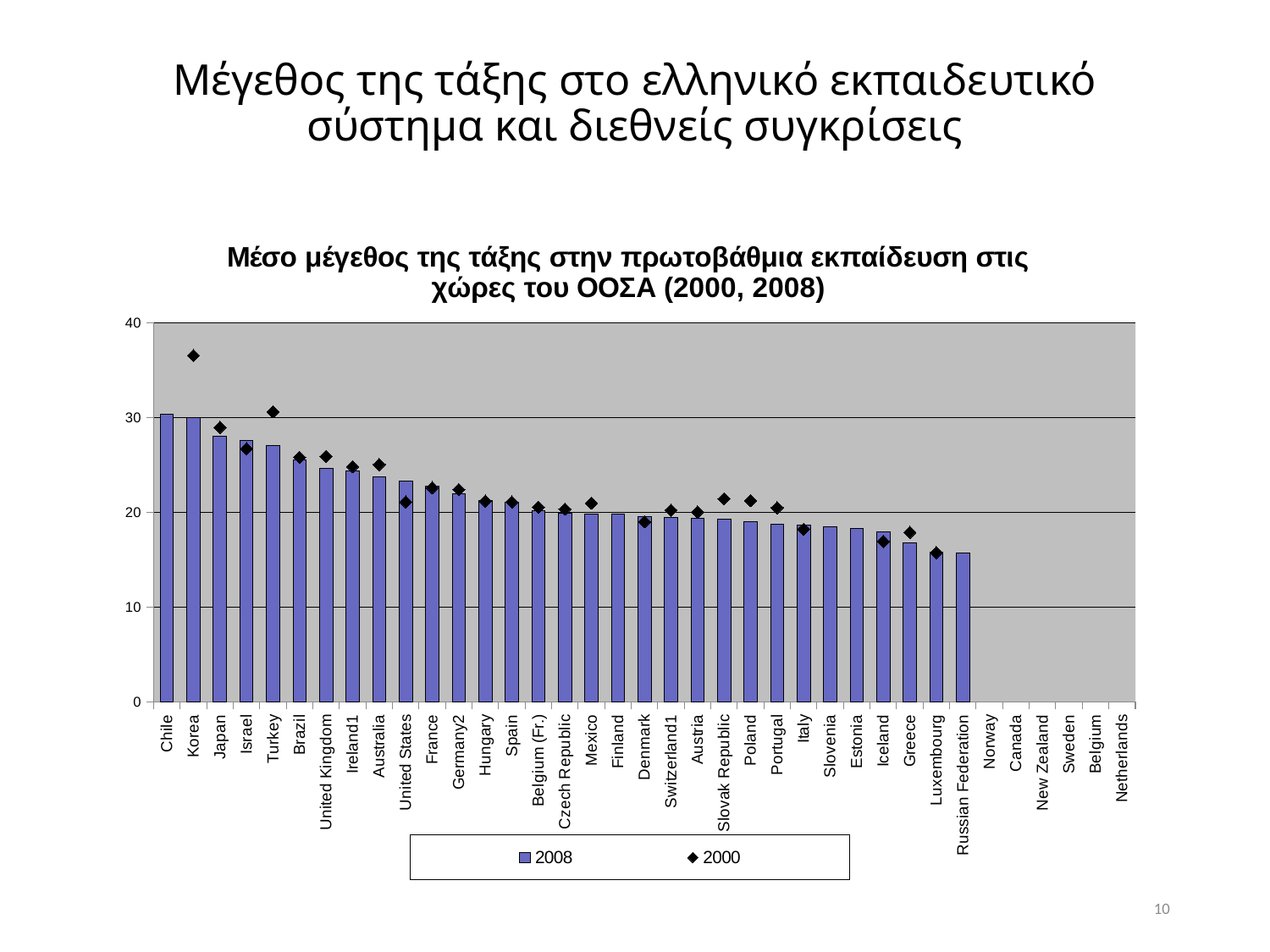
Is the 2008 value for Greece greater or less than 20? less Which has the larger 2008 value, Japan or Greece? Japan Which country has the highest 2000 value (diamond marker)? Korea Is the 2008 value for Brazil greater or less than 20? greater Do the 2008 bars rise or fall from left to right along the x axis? fall Which two series are listed in the legend? 2008 and 2000 What kind of chart is shown on the slide? Bar chart (with diamond markers for 2000) How many countries are listed on the x axis? 37 Is the 2008 value for Japan greater or less than 30? less How many series does the legend list? 2 For Korea, which is larger: the 2000 value or the 2008 value? 2000